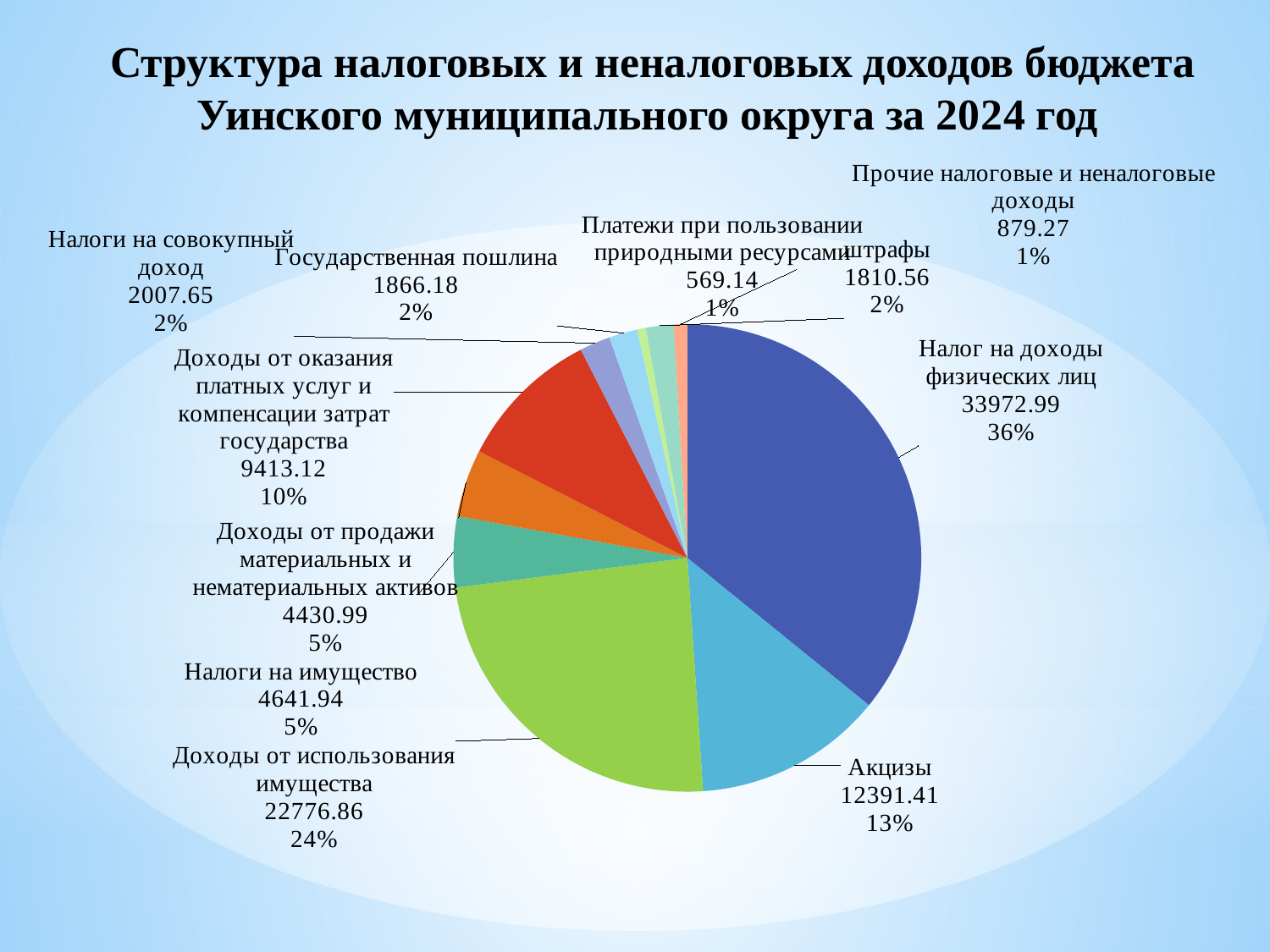
What is the difference between the values for Налог на доходы физических лиц and Доходы от использования имущества? 11196.13 Which category has the smallest value? Платежи при пользовании природными ресурсами What share of the pie does Доходы от оказания платных услуг и компенсации затрат государства represent? 10% Which category has the largest share of the pie? Налог на доходы физических лиц Which is larger: Акцизы or Доходы от оказания платных услуг и компенсации затрат государства? Акцизы What is the value for Налог на доходы физических лиц? 33972.99 What is the value for Акцизы? 12391.41 How many categories (slices) does the pie chart have? 11 What share of the pie does Доходы от использования имущества represent? 24% What type of chart is shown on the slide? Pie chart What is the value for Доходы от использования имущества? 22776.86 What is the value for Штрафы? 1810.56